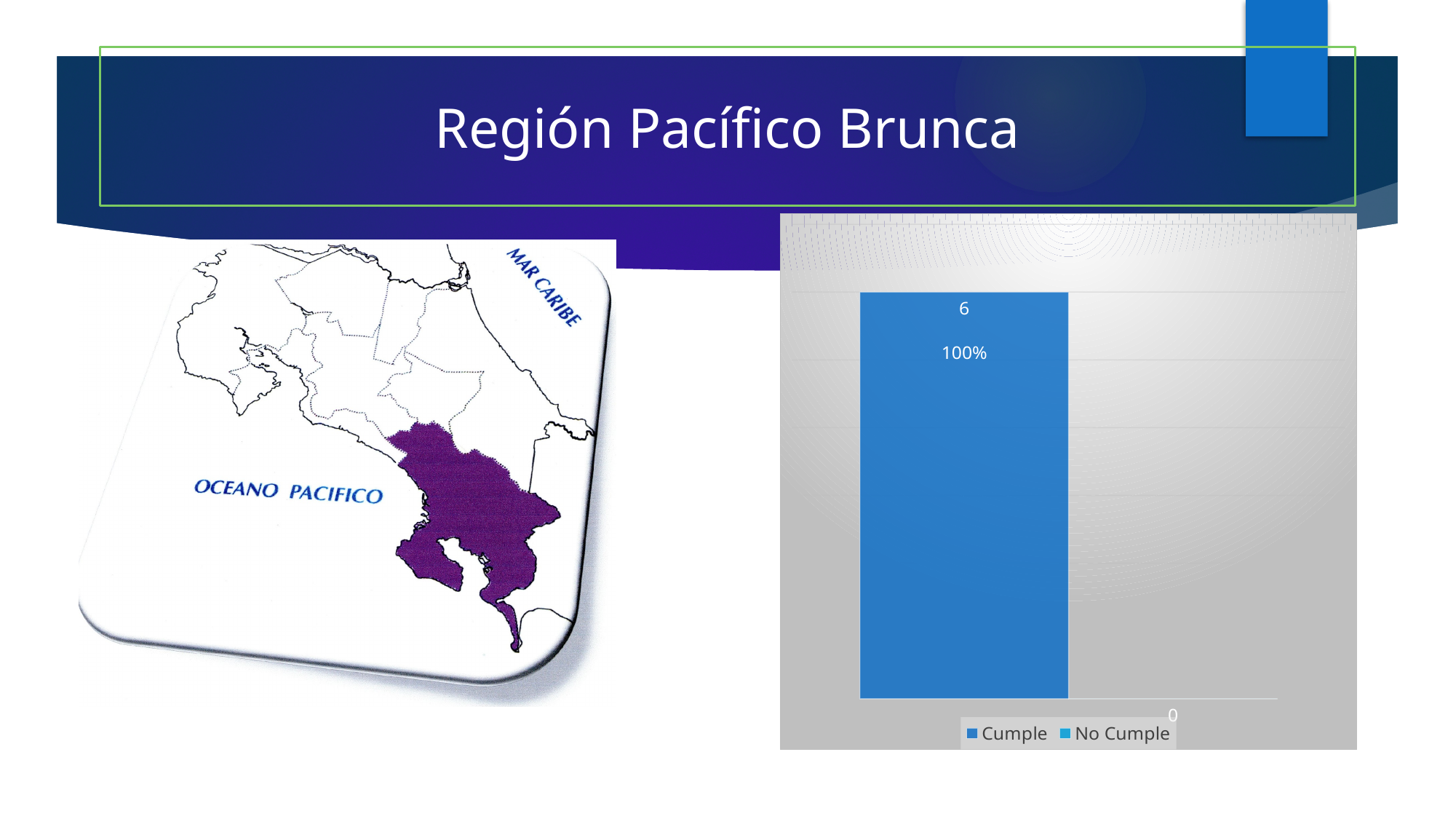
What value is shown for the No Cumple series in the bar chart? 0 Which series has the higher value, Cumple or No Cumple? Cumple Which series has the lowest value in the bar chart? No Cumple Which series has the highest value in the bar chart? Cumple How many series does the legend of the bar chart list? 2 What kind of chart is shown on the right side of the slide? Bar chart What are the two legend entries in the bar chart? Cumple and No Cumple What is the difference between the Cumple value and the No Cumple value? 6 What value is shown for the Cumple series in the bar chart? 6 What is the title of the slide containing the bar chart? Región Pacífico Brunca What percentage label is shown on the Cumple bar? 100%